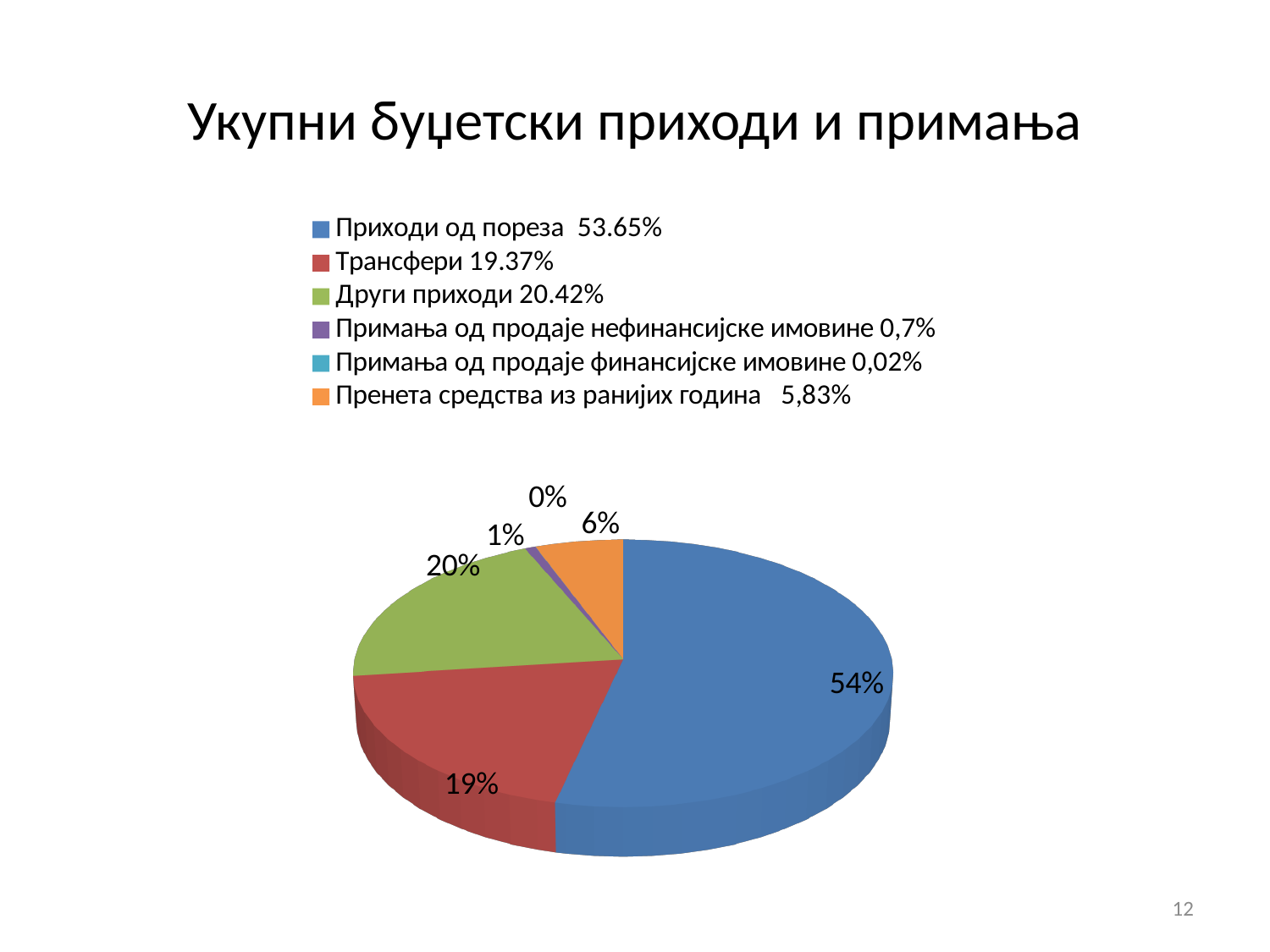
Which category has the largest share of the pie? Приходи од пореза How many slices does the pie chart have? 6 What is the title of the slide? Укупни буџетски приходи и примања How many entries does the legend list? 6 What percentage label is shown on the slice for Трансфери? 19% What colour is the slice for Приходи од пореза? blue Which is larger, the share for Други приходи or the share for Трансфери? Други приходи What is the difference between the slice labels for Приходи од пореза (54%) and Трансфери (19%)? 35% What percentage label is shown on the slice for Пренета средства из ранијих година? 6% What percentage label is shown on the slice for Други приходи? 20% What kind of chart is shown on the slide? pie chart Which category has the smallest share of the pie? Примања од продаје финансијске имовине